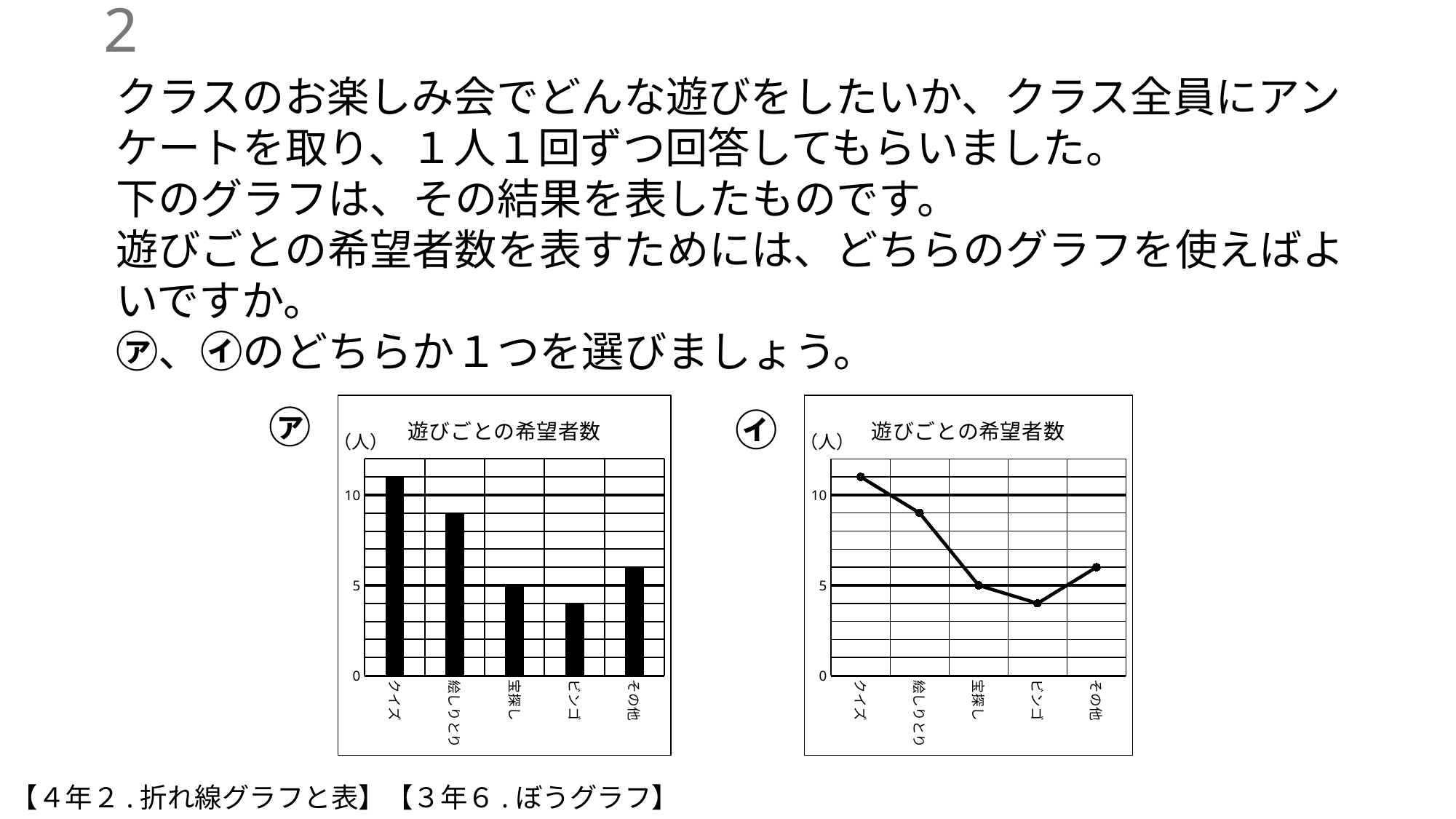
In chart イ (the right chart), is the value for ビンゴ greater or less than 5? less In chart ア (the left chart), what is the value for 宝探し? 5 In chart ア (the left chart), which is larger, the value for 絵しりとり or the value for その他? 絵しりとり What kind of chart is chart ア (the left chart)? bar chart In chart イ (the right chart), which category has the lowest value? ビンゴ In chart イ (the right chart), do the values rise or fall from クイズ to ビンゴ? fall What kind of chart is chart イ (the right chart)? line chart In chart ア (the left chart), is the value for クイズ greater or less than 10? greater In chart イ (the right chart), how many data points are plotted? 5 What is the title of chart イ (the right chart)? 遊びごとの希望者数 In chart ア (the left chart), which category has the highest value? クイズ In chart ア (the left chart), how many categories are shown on the x axis? 5